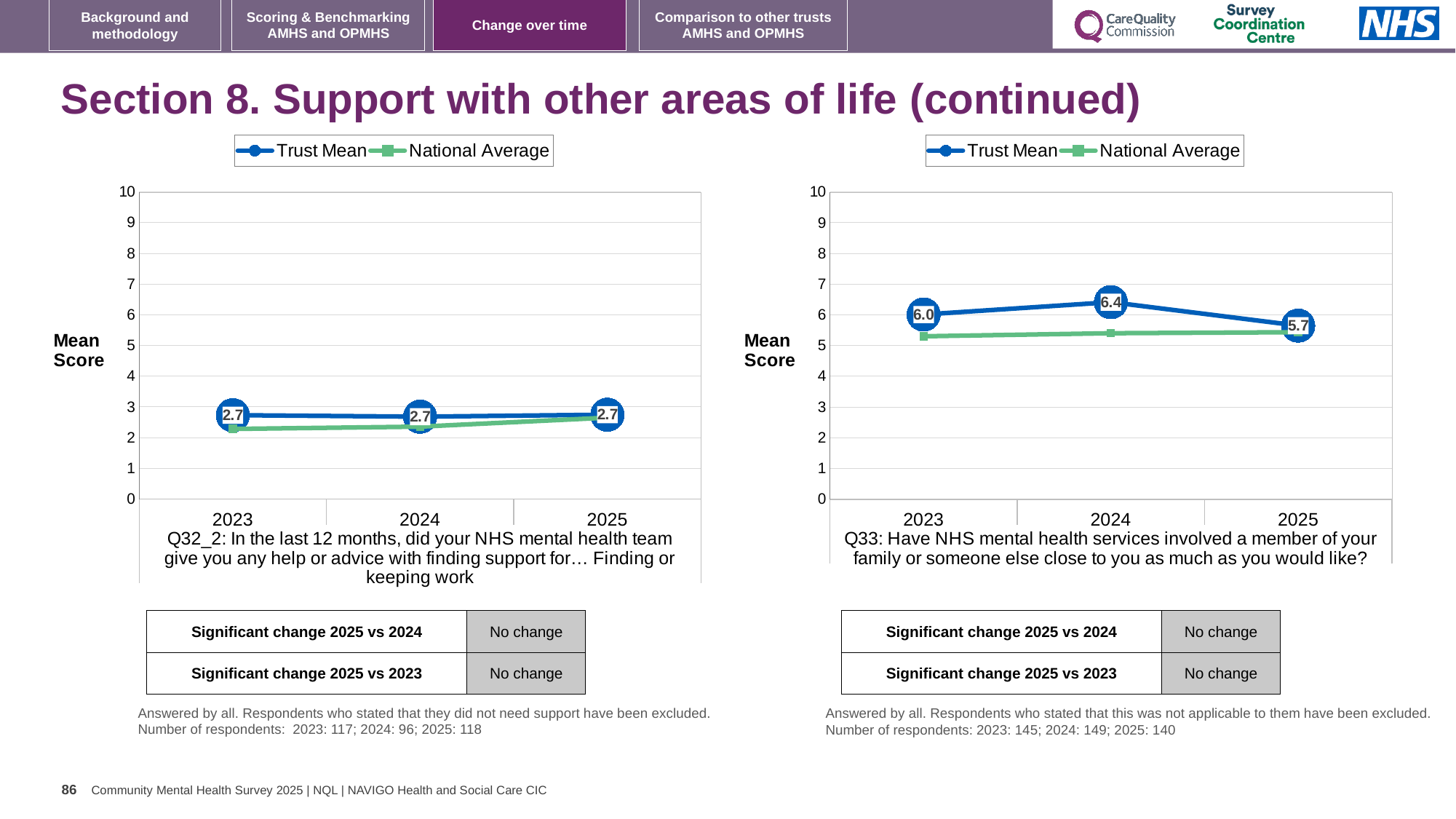
In the right chart (Q33), is the National Average value for 2023 greater or less than 5? greater In the left chart (Q32_2), is the National Average value for 2023 greater or less than 3? less In the right chart (Q33), what is the difference between the Trust Mean in 2024 and in 2025? 0.7 How many series does the legend of the right chart (Q33) list? 2 How many years are plotted on the x axis of the left chart (Q32_2)? 3 In the right chart (Q33), what is the Trust Mean value for 2025? 5.7 In the right chart (Q33), what is the Trust Mean value for 2023? 6.0 In the right chart (Q33), is the Trust Mean in 2023 or in 2024 larger? 2024 In the right chart (Q33), which year has the highest Trust Mean? 2024 In the left chart (Q32_2), what is the Trust Mean value for 2024? 2.7 In the right chart (Q33), which year has the lowest Trust Mean? 2025 What kind of chart is the left chart (Q32_2)? Line chart